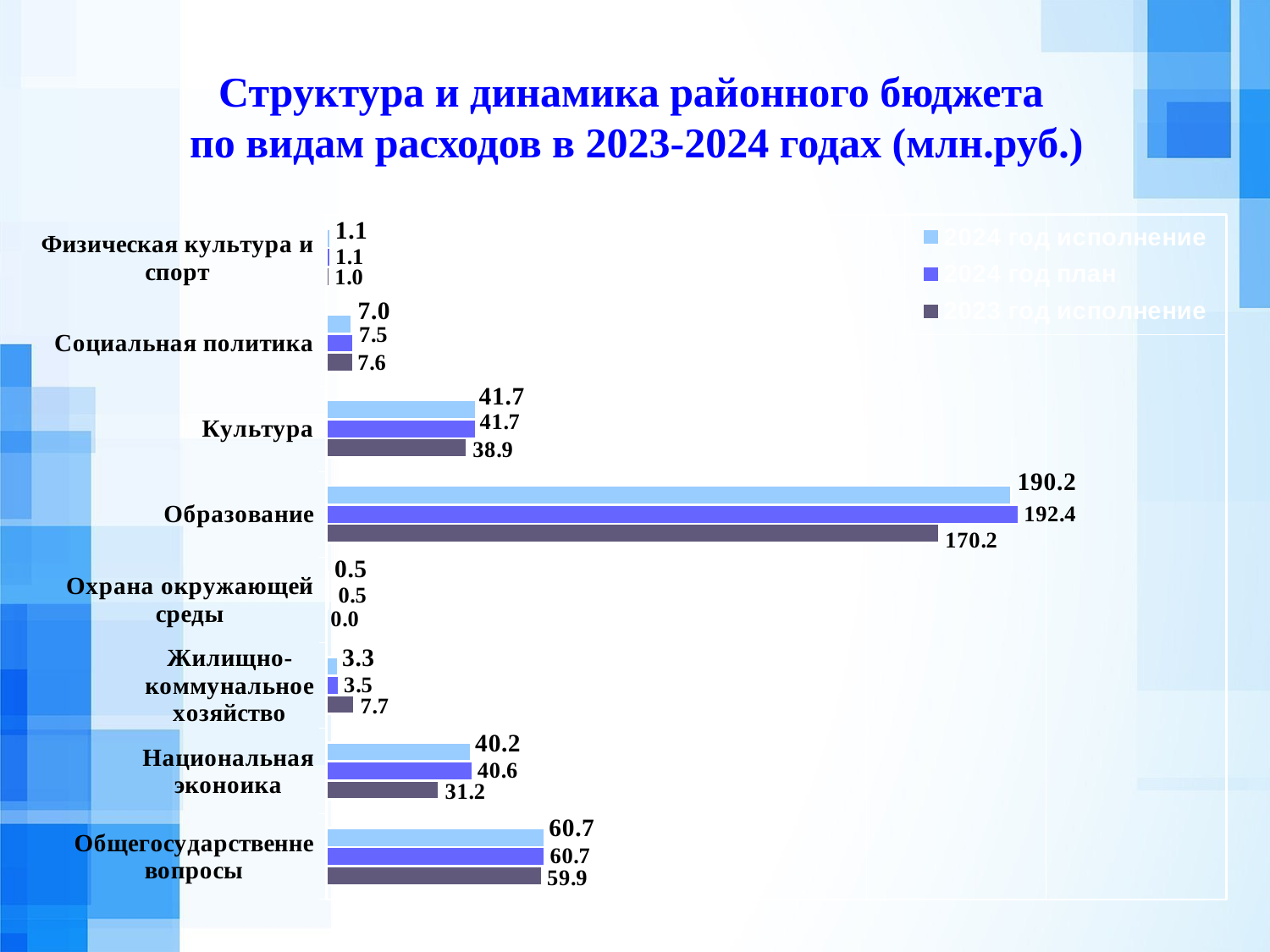
Which category has the highest 2023 год исполнение value? Образование What kind of chart is shown on the slide? bar chart What is the 2024 год план value for Образование? 192.4 What is the difference between the 2024 год исполнение values for Культура and Национальная экономика? 1.5 What is the 2023 год исполнение value for Национальная экономика? 31.2 How many expenditure categories are shown on the chart? 8 What is the 2024 год исполнение value for Общегосударственные вопросы? 60.7 How many series does the legend list? 3 What is the title of the chart on the slide? Структура и динамика районного бюджета по видам расходов в 2023-2024 годах (млн.руб.) What is the difference between the 2024 год план and 2023 год исполнение values for Образование? 22.2 For Жилищно-коммунальное хозяйство, which is larger: the 2023 год исполнение value or the 2024 год план value? 2023 год исполнение Which category has the lowest 2024 год план value? Охрана окружающей среды